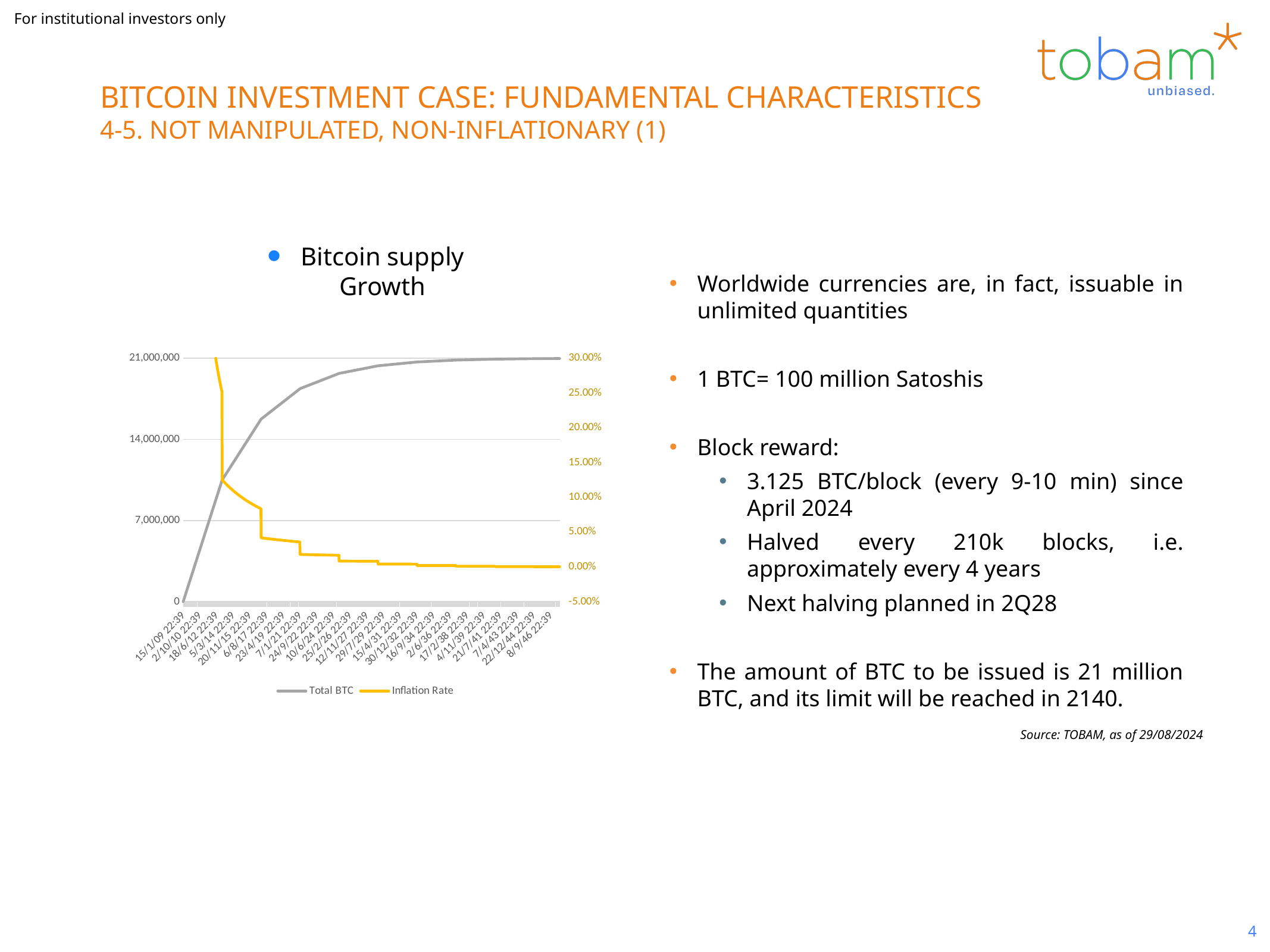
Is the Total BTC value at 8/9/46 22:39 greater or less than 14,000,000? greater What are the two series named in the chart's legend? Total BTC and Inflation Rate Does the Total BTC series rise or fall along the x axis? Rise Is the Inflation Rate value at 6/8/17 22:39 greater or less than 10.00%? less Is the Inflation Rate value at 5/3/14 22:39 greater or less than 5.00%? greater What kind of chart is shown on the slide? Line chart Does the Inflation Rate series rise or fall along the x axis? Fall How many series does the chart's legend list? 2 What is the title of the chart? Bitcoin supply Growth